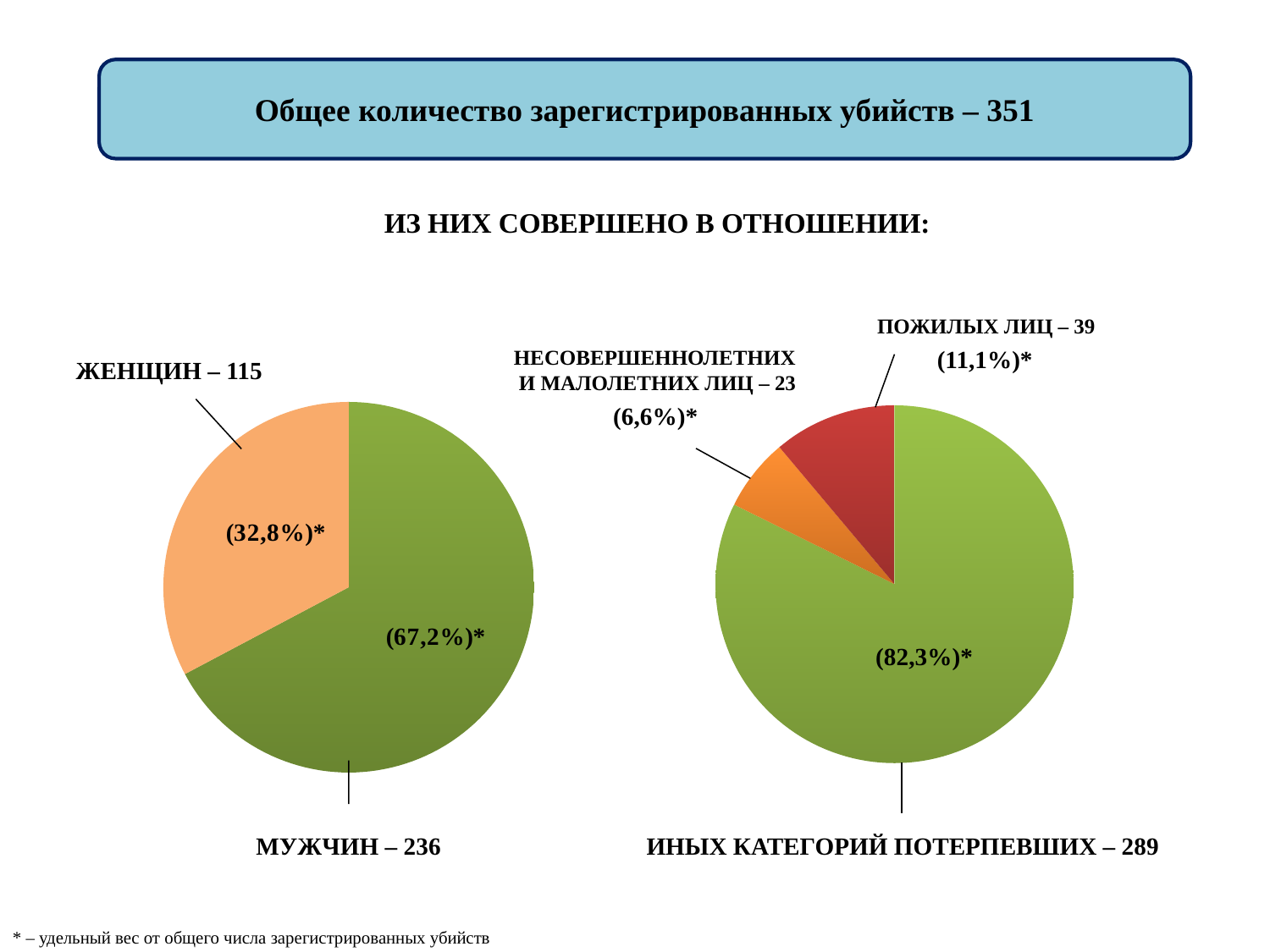
In the left pie chart, what is the difference between the number of murders against men (236) and against women (115)? 121 In the left pie chart, which category has the larger slice, ЖЕНЩИН or МУЖЧИН? МУЖЧИН What total number of registered murders is stated in the header box at the top of the slide? 351 In the left pie chart, what share of registered murders were committed against men (МУЖЧИН)? 67,2% In the right pie chart, which category has the largest slice? ИНЫХ КАТЕГОРИЙ ПОТЕРПЕВШИХ How many slices does the left pie chart have? 2 In the right pie chart, which category has the smallest slice? НЕСОВЕРШЕННОЛЕТНИХ И МАЛОЛЕТНИХ ЛИЦ How many slices does the right pie chart have? 3 In the right pie chart, what share of registered murders were committed against minors and young children (НЕСОВЕРШЕННОЛЕТНИХ И МАЛОЛЕТНИХ ЛИЦ)? 6,6% What type of chart is the left chart on the slide? pie chart In the left pie chart, how many murders were committed against women (ЖЕНЩИН)? 115 In the right pie chart, how many murders were committed against elderly persons (ПОЖИЛЫХ ЛИЦ)? 39